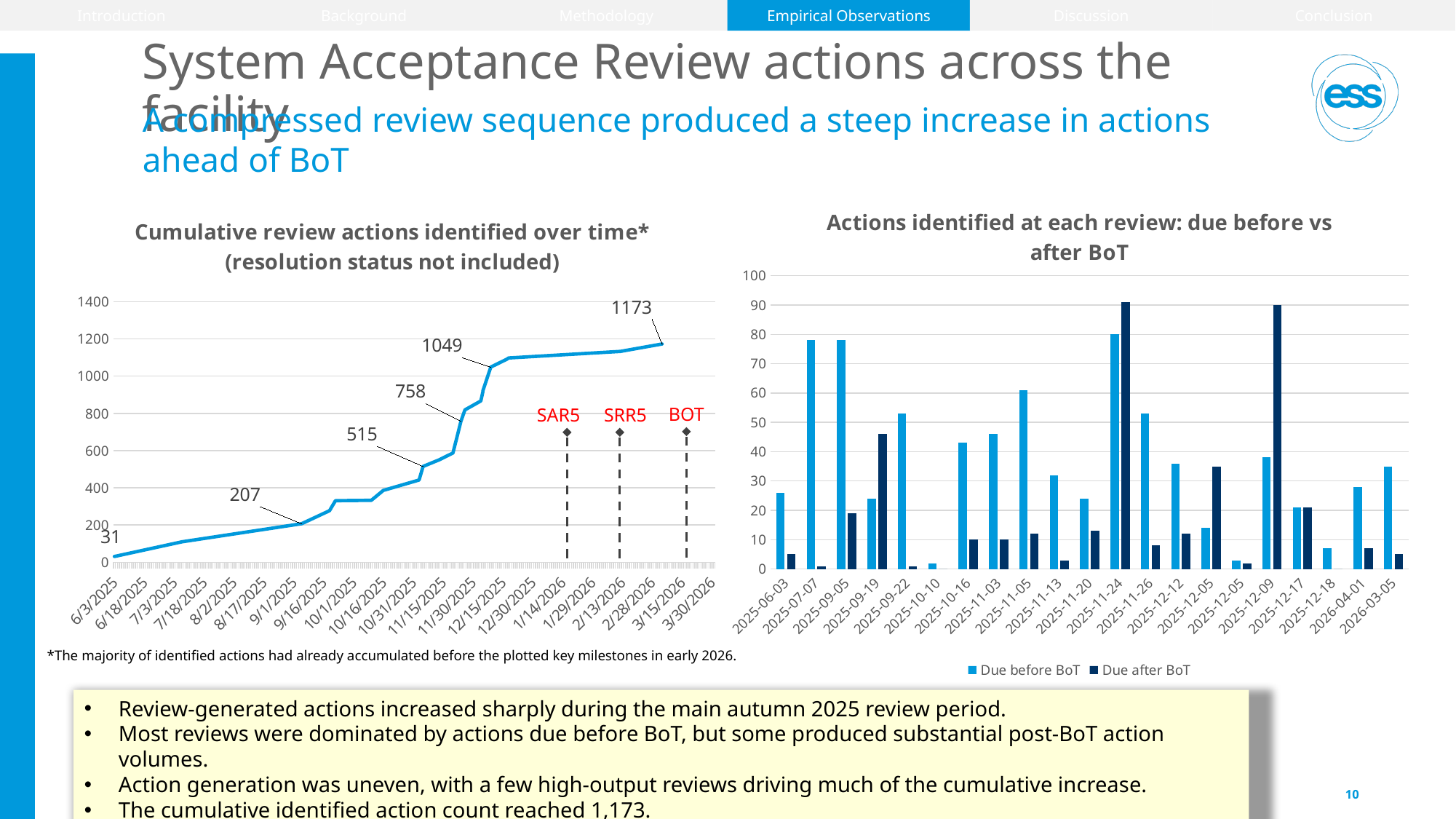
In the 'Actions identified at each review' chart, for 2025-09-19, which is larger: 'Due before BoT' or 'Due after BoT'? Due after BoT In the 'Cumulative review actions identified over time' chart, do the values rise or fall along the x axis? rise In the 'Cumulative review actions identified over time' chart, what is the first labelled value at the start of the line? 31 In the 'Actions identified at each review' chart, is the 'Due before BoT' value for 2025-10-10 greater or less than 10? less What kind of chart is 'Actions identified at each review: due before vs after BoT'? bar chart In the 'Cumulative review actions identified over time' chart, what labelled value comes immediately after 515? 758 In the 'Cumulative review actions identified over time' chart, which three milestones are marked with dashed vertical lines? SAR5, SRR5, BOT What kind of chart is 'Cumulative review actions identified over time'? line chart In the 'Cumulative review actions identified over time' chart, what is the difference between the labelled values 1173 and 1049? 124 In the 'Cumulative review actions identified over time' chart, what is the final labelled cumulative value? 1173 How many series does the legend of the 'Actions identified at each review: due before vs after BoT' chart list? 2 In the 'Actions identified at each review' chart, is the 'Due before BoT' value for 2025-11-05 greater or less than 50? greater